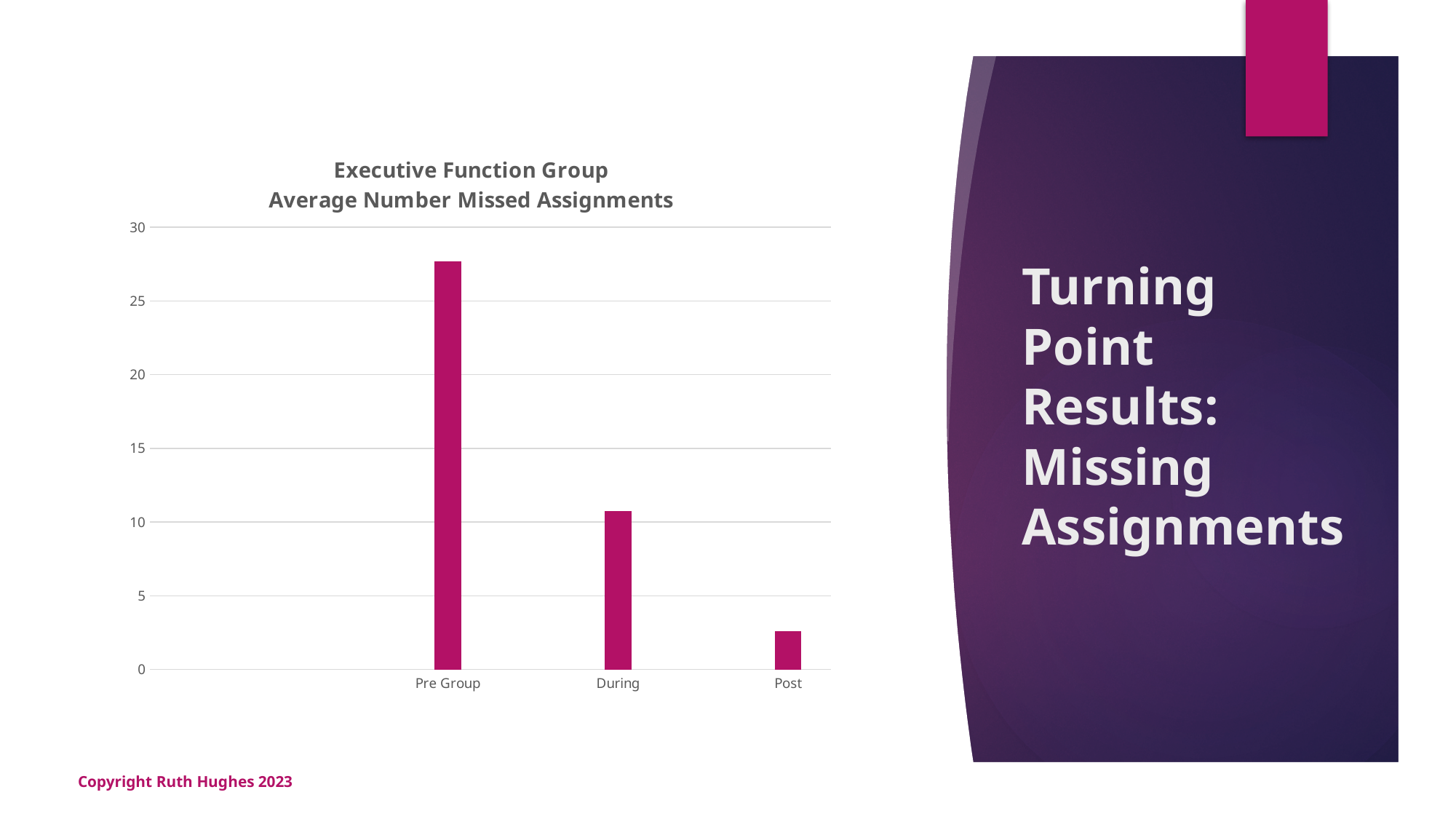
Do the values rise or fall from Pre Group to Post along the x axis? fall What is the title of the chart? Executive Function Group Average Number Missed Assignments How many categories are shown on the x axis of the chart? 3 Is the value for During greater or less than 15? less Which category has the highest average number of missed assignments? Pre Group Which is larger, the value for During or the value for Post? During Is the value for Post greater or less than 5? less What kind of chart is shown on the slide? bar chart Which category has the lowest average number of missed assignments? Post Is the value for Pre Group greater or less than 25? greater What is the maximum value shown on the vertical axis of the chart? 30